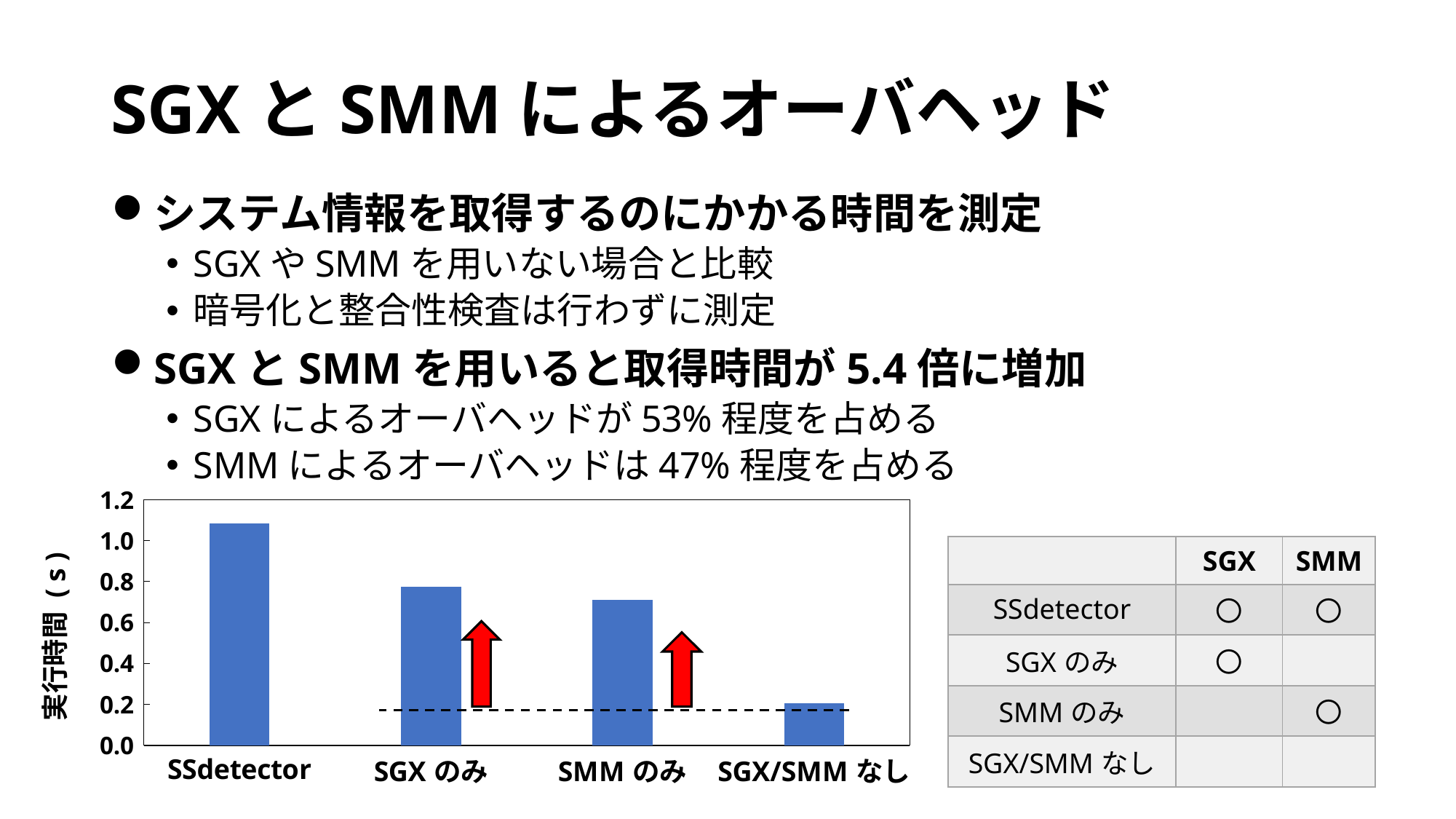
How many categories are plotted in the bar chart? 4 Do the bar values rise or fall from left to right across the categories? fall Which has a larger value in the bar chart, SSdetector or SGX のみ? SSdetector Is the value for SSdetector greater or less than 1.0? greater Which category has the highest execution time in the bar chart? SSdetector Which has a larger value in the bar chart, SMM のみ or SGX/SMM なし? SMM のみ Is the value for SGX のみ greater or less than 0.6? greater Which category has the lowest execution time in the bar chart? SGX/SMM なし What kind of chart is shown on the slide? bar chart What is the label of the vertical axis of the bar chart? 実行時間（s） Is the value for SGX/SMM なし greater or less than 0.4? less